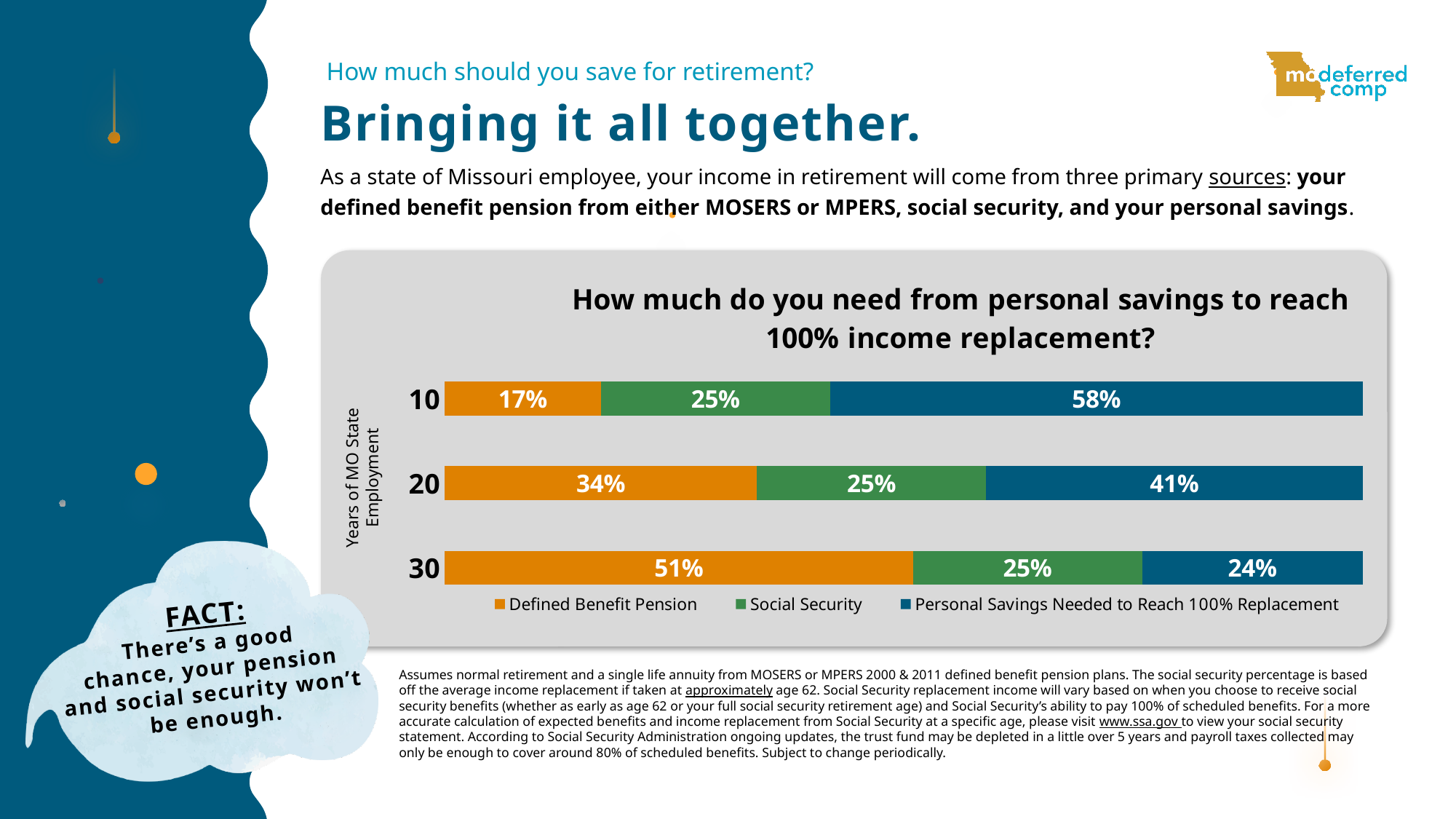
What is the Social Security value for 20 years of MO State Employment? 25% What is the Personal Savings Needed to Reach 100% Replacement value for 30 years of MO State Employment? 24% What is the difference between the Personal Savings Needed values for 10 years and 30 years of employment? 34% Which years-of-employment category has the highest Defined Benefit Pension value? 30 Which years-of-employment category has the lowest Personal Savings Needed to Reach 100% Replacement value? 30 What is the Defined Benefit Pension value for 10 years of MO State Employment? 17% Does the Defined Benefit Pension value rise or fall as years of MO State Employment increase from 10 to 30? Rise How many years-of-employment categories are shown in the chart? 3 What is the title of the chart? How much do you need from personal savings to reach 100% income replacement? Which is larger: the Defined Benefit Pension value for 20 years or the Personal Savings Needed value for 20 years? Personal Savings Needed to Reach 100% Replacement How many series does the legend list? 3 What kind of chart is shown on the slide? Stacked bar chart